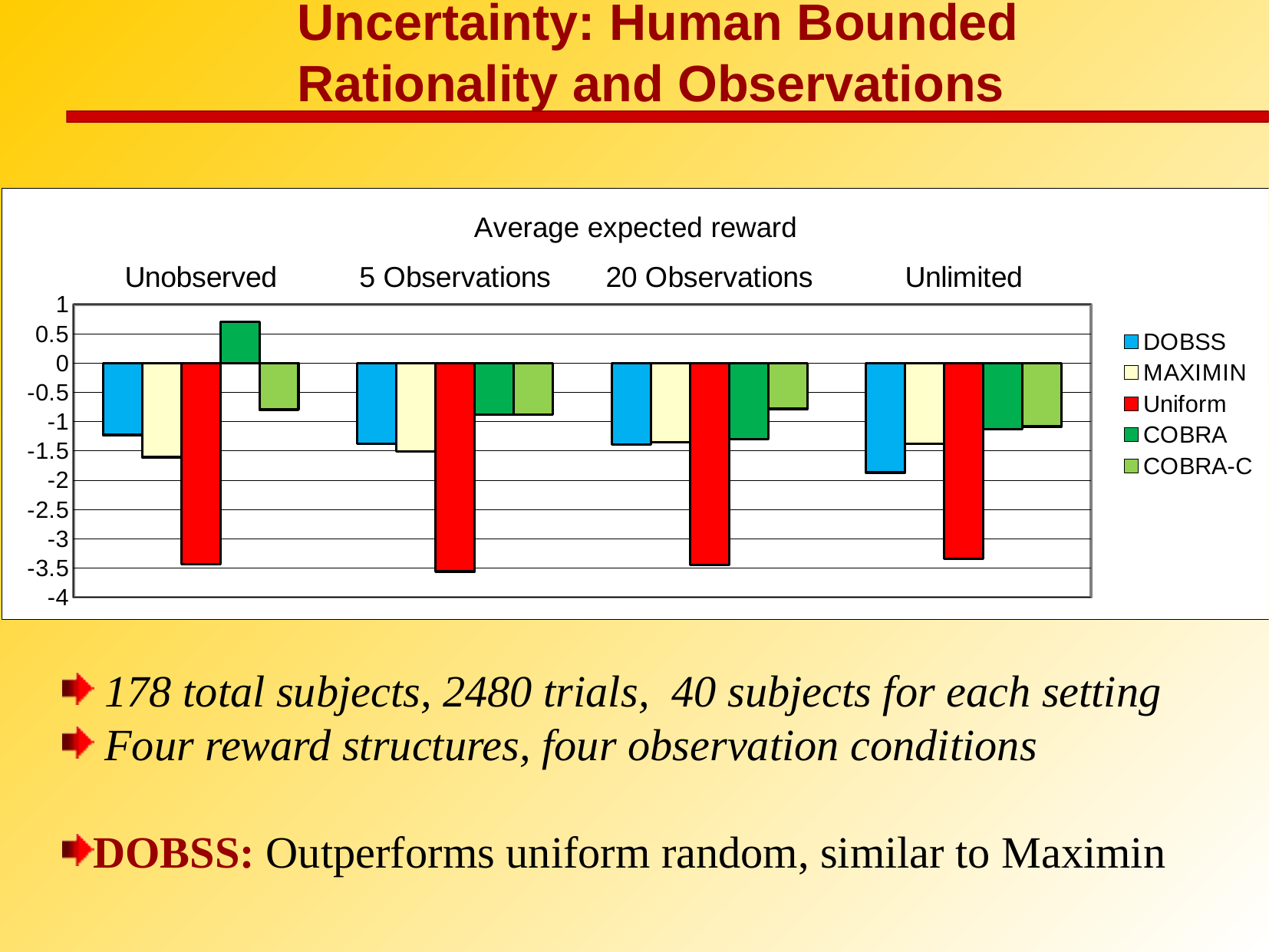
In the Unobserved condition, which series has the lowest average expected reward? Uniform How many series does the legend of the chart list? 5 How many observation conditions (categories) are shown along the x axis of the chart? 4 Is the value for DOBSS in the Unlimited condition greater or less than -1.5? less In the Unobserved condition, which series has the highest average expected reward? COBRA What kind of chart is shown on the slide? bar chart In the Unlimited condition, which series has the lowest average expected reward? Uniform Is the value for Uniform in the 5 Observations condition greater or less than -3? less In the Unobserved condition, which is larger, the value for DOBSS or the value for MAXIMIN? DOBSS In the Unlimited condition, which is larger, the value for DOBSS or the value for MAXIMIN? MAXIMIN What is the title of the chart? Average expected reward Is the value for COBRA in the Unobserved condition greater or less than 0.5? greater